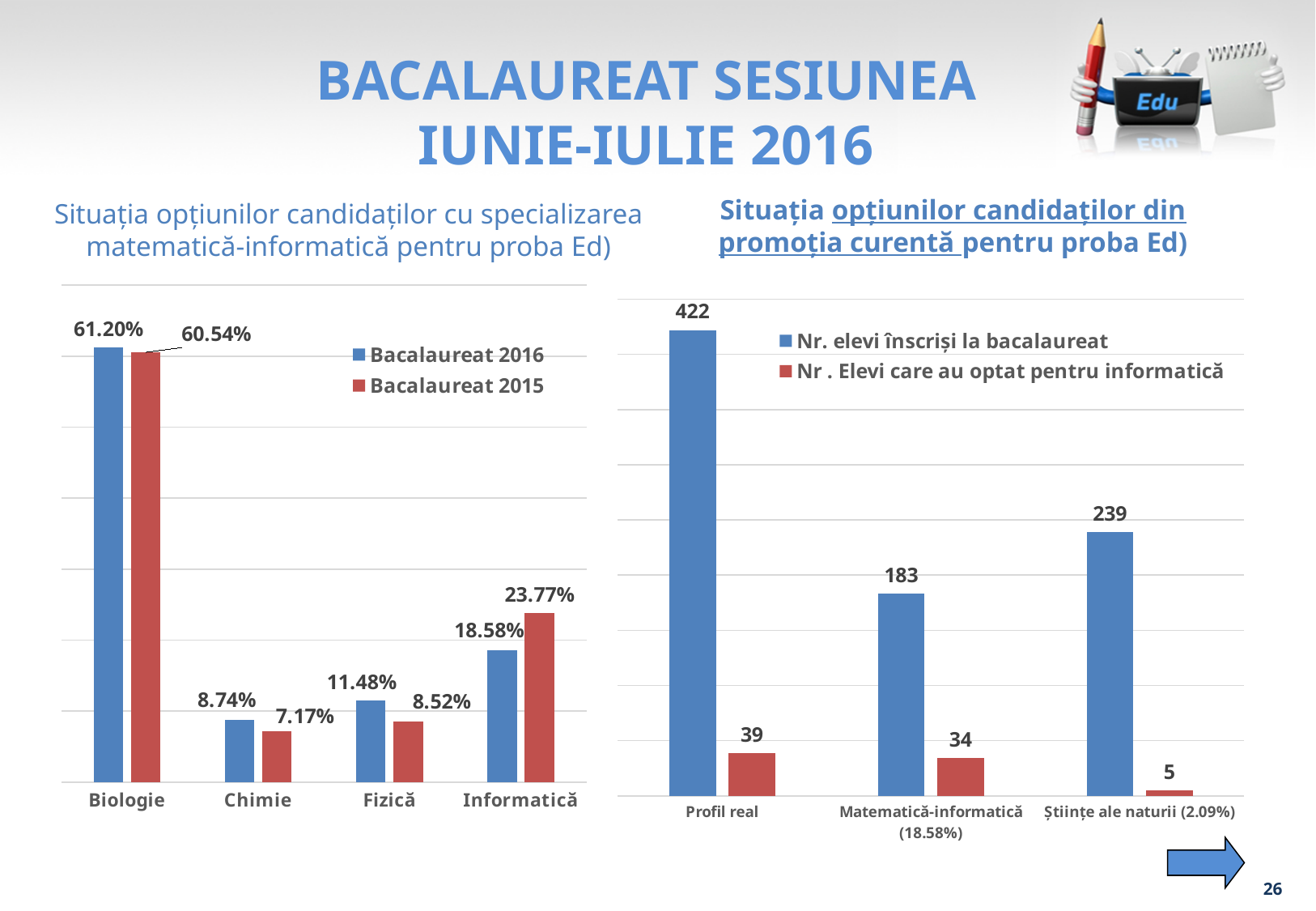
In the left chart, what is the Bacalaureat 2015 value for Informatică? 23.77% What type of chart is the right chart? Bar chart In the left chart, which category has the lowest Bacalaureat 2015 value? Chimie In the left chart, which is larger for Fizică: the Bacalaureat 2016 value or the Bacalaureat 2015 value? Bacalaureat 2016 In the left chart, what is the Bacalaureat 2016 value for Biologie? 61.20% How many series does the legend of the left chart list? 2 In the right chart, how many students opted for informatică in the Științe ale naturii (2.09%) category? 5 In the right chart, how many students are listed as 'Nr. elevi înscriși la bacalaureat' for Profil real? 422 In the right chart, what is the difference between the number of students enrolled and the number who opted for informatică in Matematică-informatică (18.58%)? 149 In the right chart, which category has the highest number of students enrolled for the bacalaureat? Profil real How many categories are shown on the x axis of the left chart? 4 In the left chart, what is the difference between the Bacalaureat 2015 and Bacalaureat 2016 values for Informatică? 5.19%